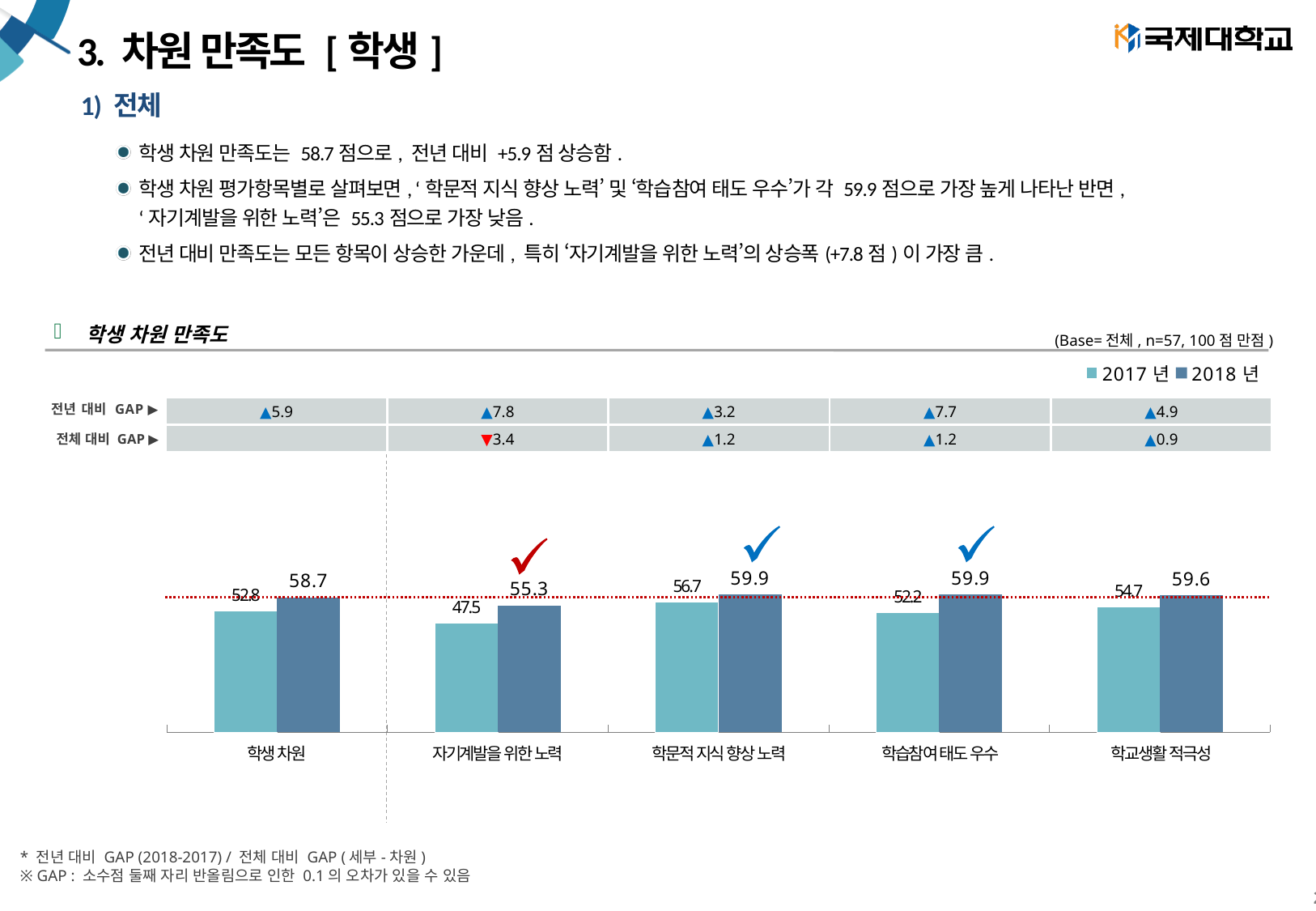
What is the title of the chart? 학생 차원 만족도 What is the 2017년 value for 학문적 지식 향상 노력? 56.7 Which category has the lowest 2017년 value? 자기계발을 위한 노력 What is the 2018년 value for 학생 차원? 58.7 What is the 2018년 value for 학교생활 적극성? 59.6 How many categories are shown on the x axis of the chart? 5 Which category has the lowest 2018년 value? 자기계발을 위한 노력 What kind of chart is shown on the slide? bar chart What is the difference between the 2018년 and 2017년 values for 학습참여 태도 우수? 7.7 Which is larger, the 2017년 value for 학교생활 적극성 or the 2017년 value for 학습참여 태도 우수? 학교생활 적극성 What is the 2017년 value for 자기계발을 위한 노력? 47.5 How many series does the legend list? 2